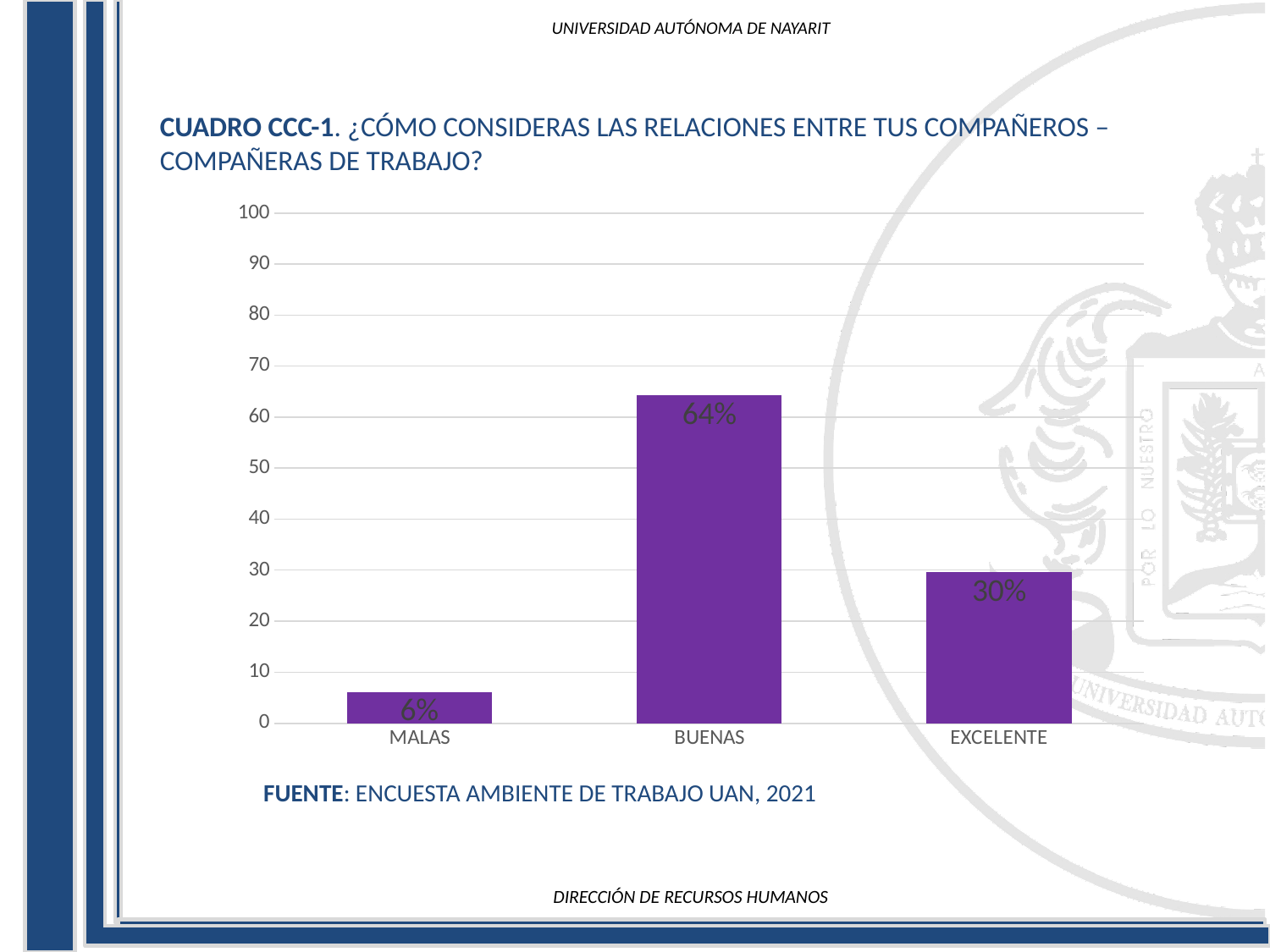
What is the value for MALAS? 6% What source is cited below the chart? ENCUESTA AMBIENTE DE TRABAJO UAN, 2021 What is the value for BUENAS? 64% Is the value for BUENAS greater or less than 50? greater Which is larger, the value for EXCELENTE or the value for MALAS? EXCELENTE What is the value for EXCELENTE? 30% Which category has the highest value? BUENAS Which category has the lowest value? MALAS How many categories are shown on the x axis? 3 What is the difference between the values for BUENAS and EXCELENTE? 34% What is the difference between the values for EXCELENTE and MALAS? 24% What kind of chart is shown on the slide? bar chart